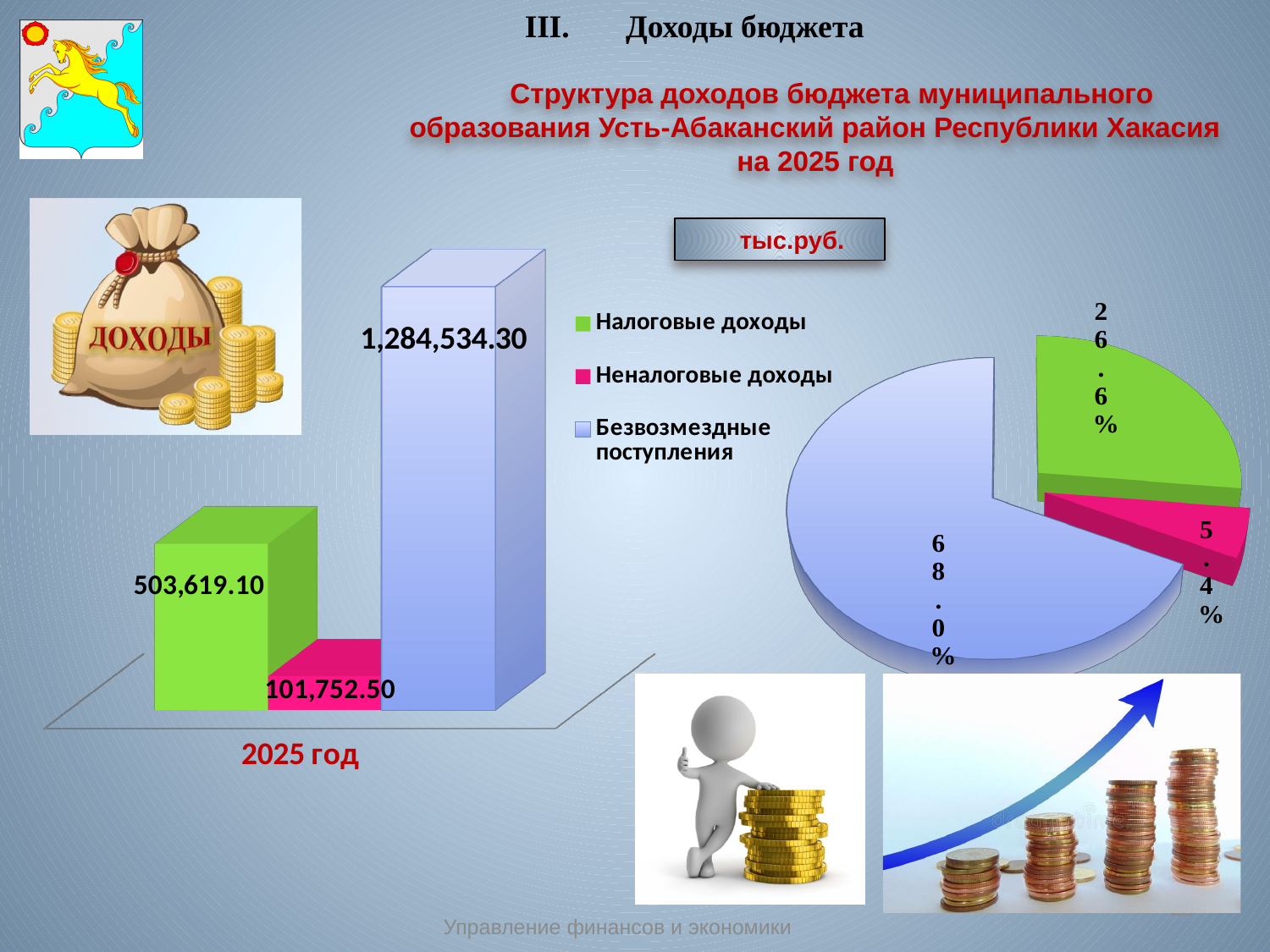
What kind of chart is shown on the left side of the slide? Bar chart On the pie chart, what share does the green slice (Налоговые доходы) have? 26.6% What unit is indicated in the box above the charts? тыс.руб. On the bar chart, which is larger: Налоговые доходы or Неналоговые доходы? Налоговые доходы On the bar chart, which series has the lowest value? Неналоговые доходы On the bar chart, what is the value for Налоговые доходы? 503,619.10 How many series does the legend of the bar chart list? 3 On the pie chart, what share does the blue slice (Безвозмездные поступления) have? 68.0% On the bar chart, what is the difference between Безвозмездные поступления and Налоговые доходы? 780,915.20 On the bar chart, what is the value for Неналоговые доходы? 101,752.50 On the bar chart, what is the value for Безвозмездные поступления? 1,284,534.30 On the bar chart, which series has the highest value? Безвозмездные поступления